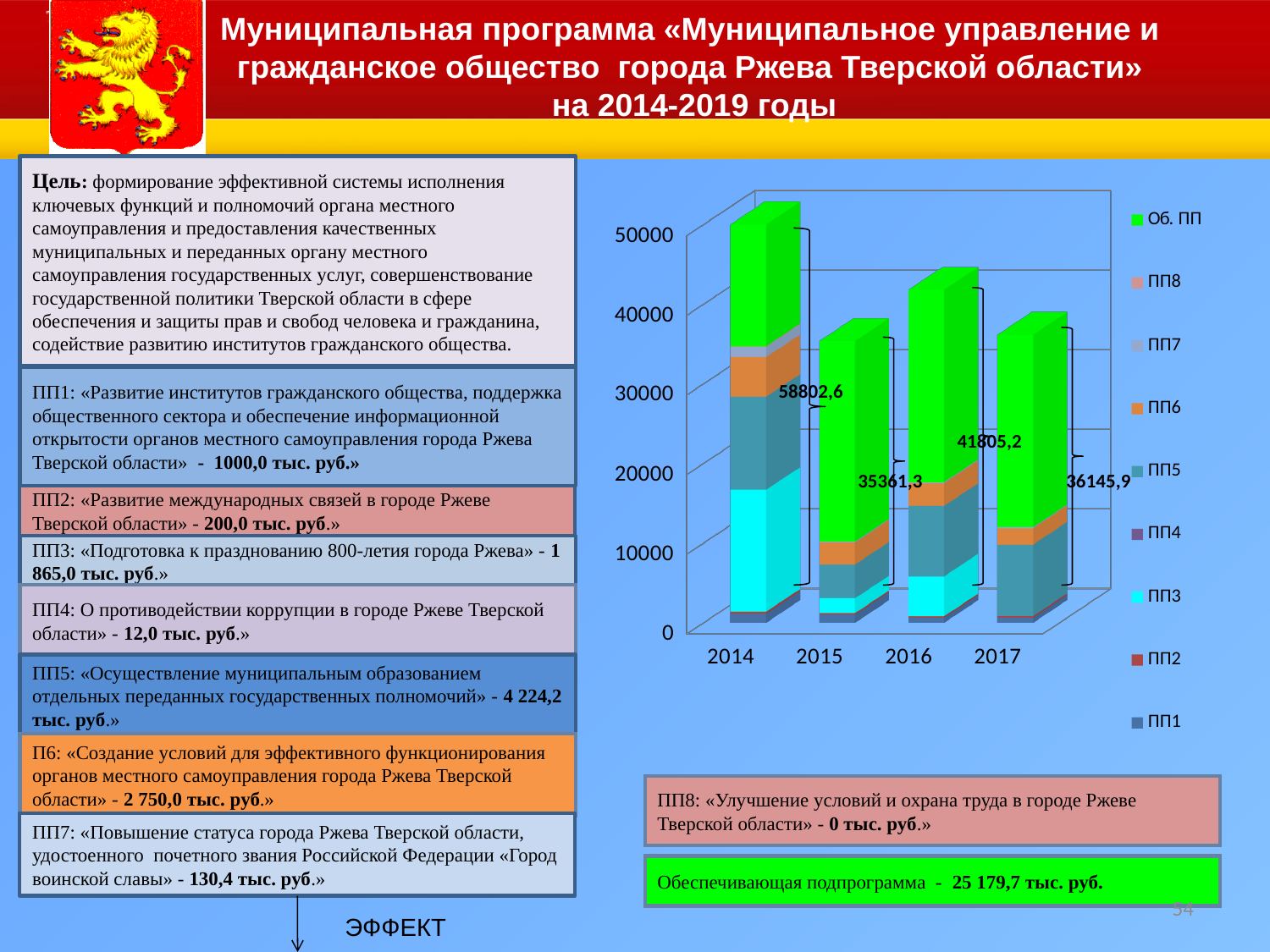
What is the total value labelled on the bar for 2016? 41805,2 Which year has the lowest total in the chart? 2015 How many series does the chart legend list? 9 What is the total value labelled on the bar for 2014? 58802,6 What kind of chart is shown on the slide? stacked bar chart Which year has the highest total in the chart? 2014 What is the total value labelled on the bar for 2015? 35361,3 Which year has the larger total, 2016 or 2017? 2016 What is the difference between the total for 2014 and the total for 2015? 23441,3 How many years (categories) are shown on the x axis of the chart? 4 Which series is listed first (at the top) in the chart legend? Об. ПП